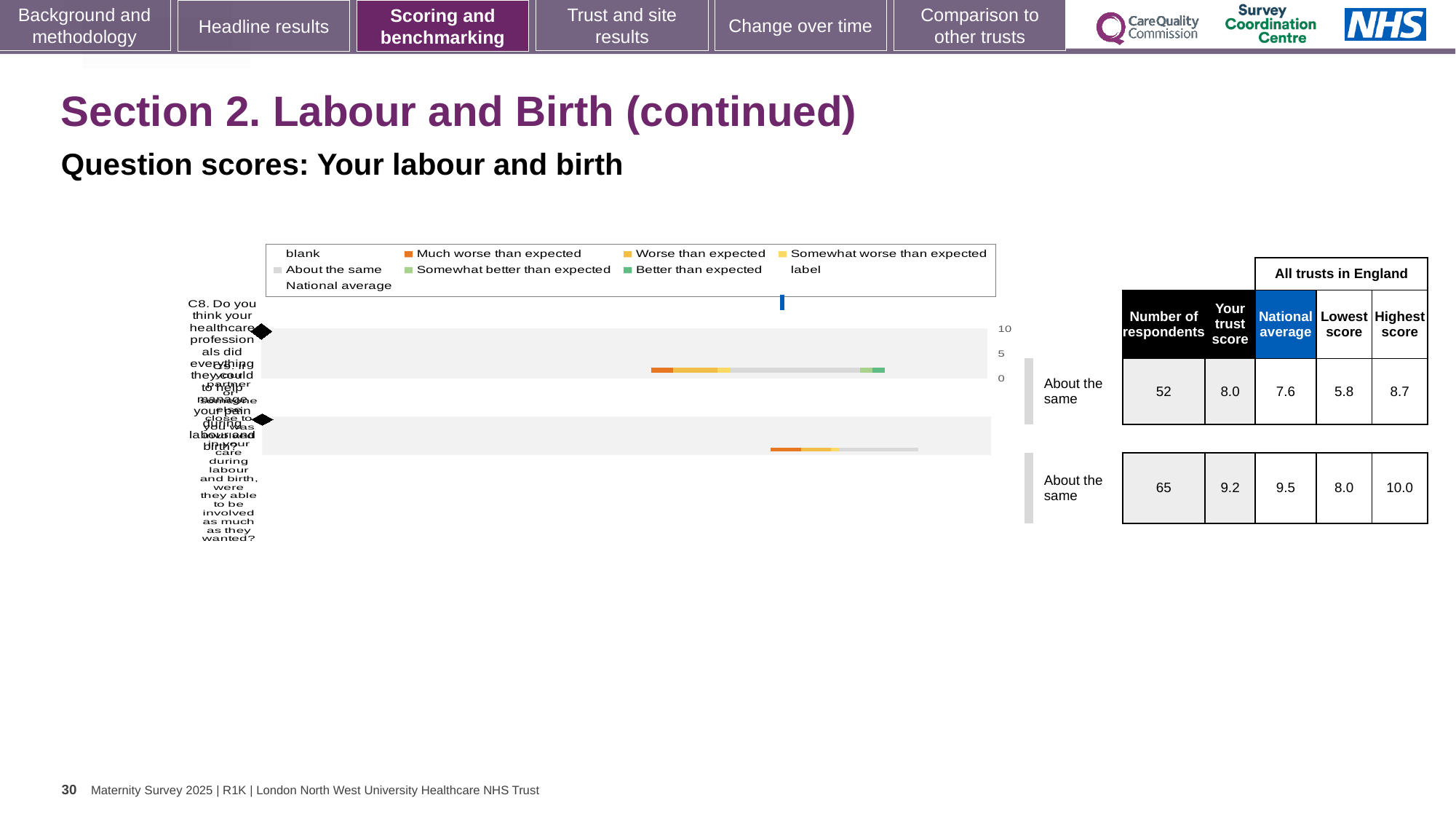
What kind of chart is shown on the slide? bar chart In the table beside the chart, what is 'Your trust score' for the first row (C8, managing pain during labour and birth)? 8.0 How many entries does the chart legend list? 9 For the first row (C8) in the table, what is the difference between the highest score and the lowest score across all trusts in England? 2.9 How many bars (question rows) are plotted in the chart? 2 What colour does the legend use for 'Much worse than expected'? orange What is the highest tick value shown on the chart's score axis? 10 In the table beside the chart, what is the 'National average' for the second row? 9.5 In the table beside the chart, what is the 'Highest score' for the second row? 10.0 What benchmark category label is shown next to both bars in the chart? About the same For the first row (C8) in the table, which is larger: 'Your trust score' or the 'National average'? Your trust score In the table beside the chart, how many respondents are listed for the first row (C8)? 52